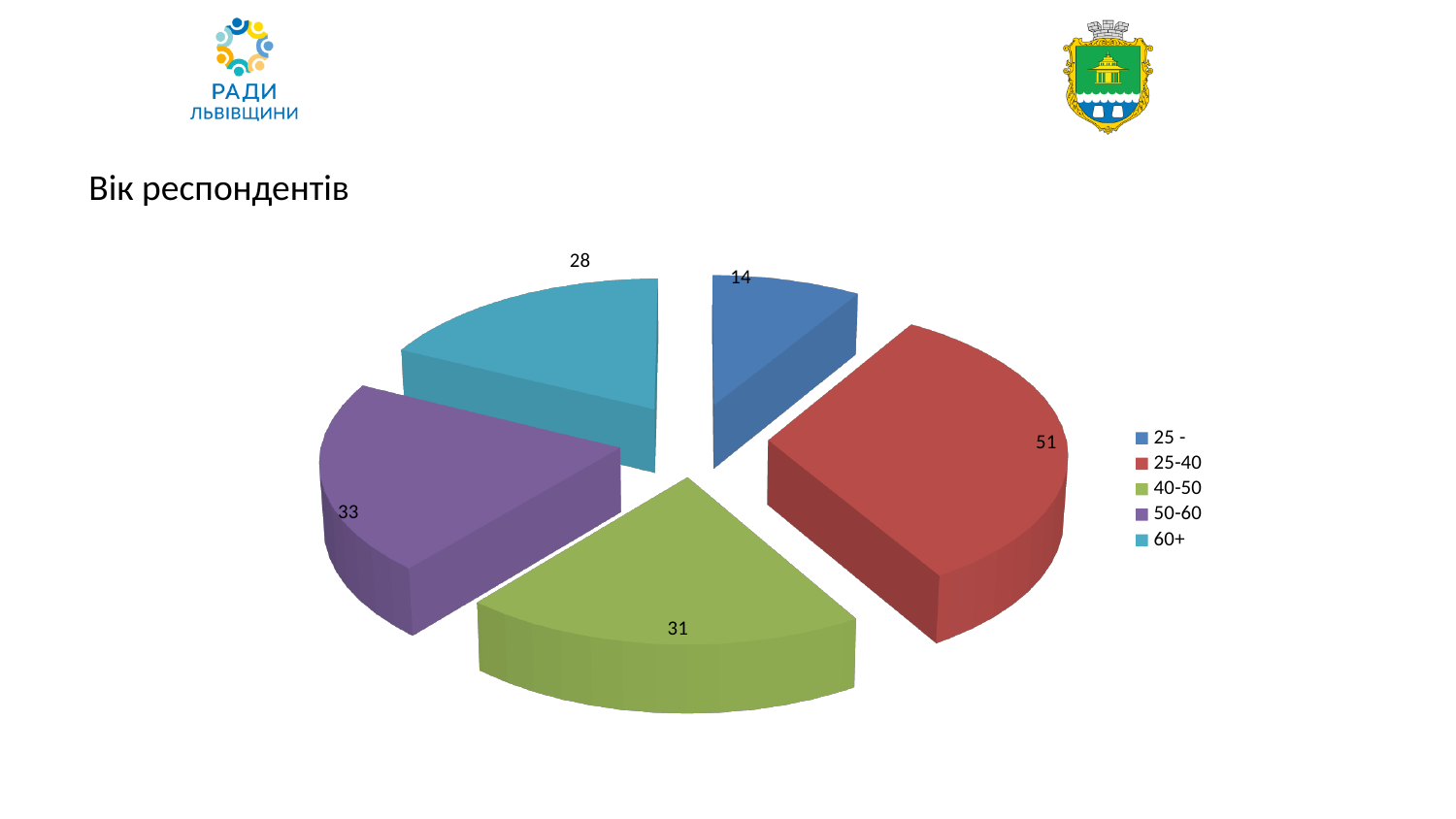
What is the value for the 40-50 age group? 31 How many slices does the pie chart have? 5 What type of chart is shown on the slide? Pie chart What is the value for the 60+ age group? 28 Which age group has the largest slice of the pie? 25-40 Which is larger, the value for 50-60 or the value for 40-50? 50-60 What is the value for the 50-60 age group? 33 What is the title of the chart on the slide? Вік респондентів What is the difference between the values for the 25-40 and 25 - age groups? 37 What is the value for the 25-40 age group in the pie chart? 51 Which age group has the smallest slice of the pie? 25 - What is the total of all the values shown in the pie chart? 157